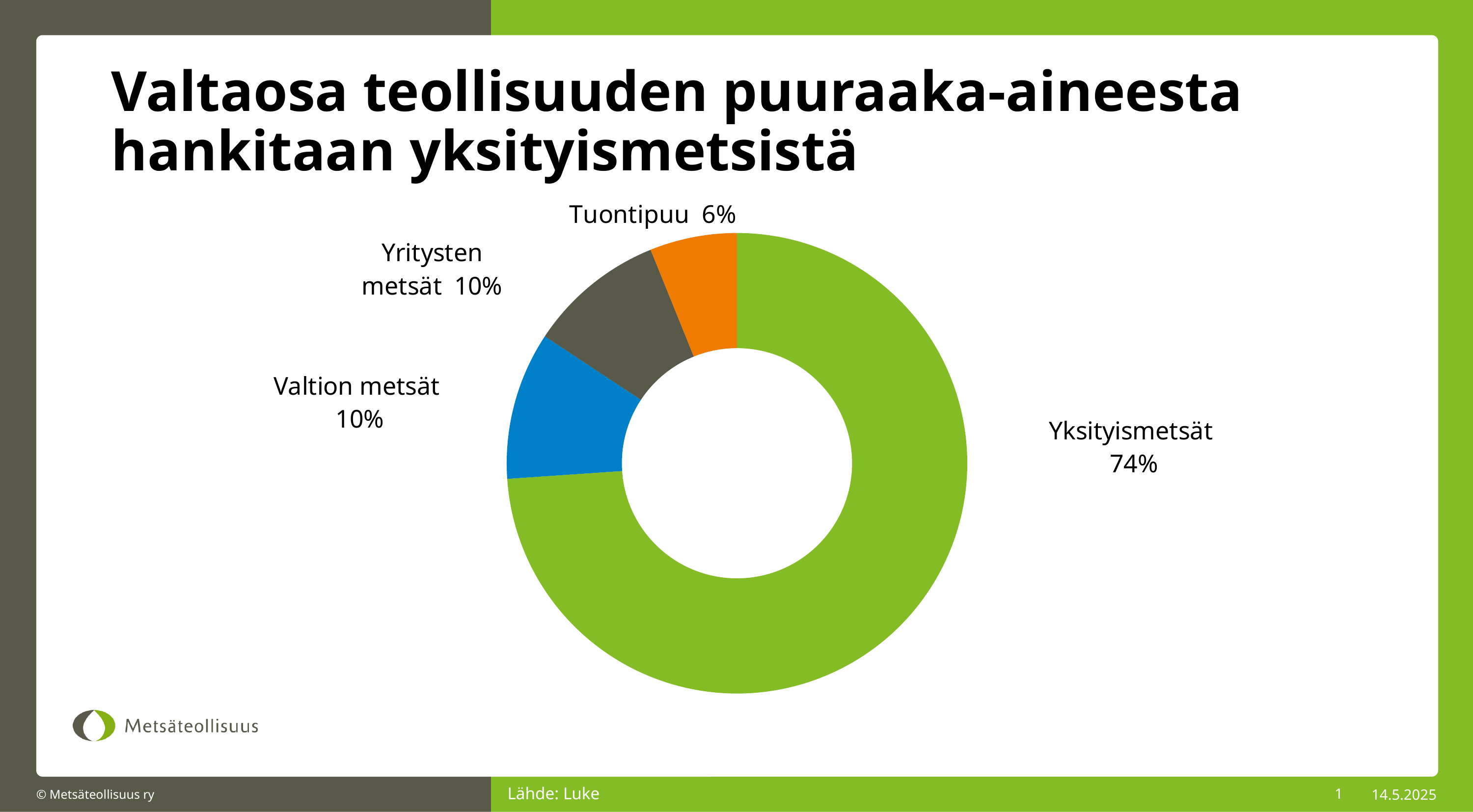
Which is larger, the share of Valtion metsät or the share of Tuontipuu? Valtion metsät What is the difference between the shares of Yksityismetsät and Valtion metsät? 64% What share of the chart does Yksityismetsät account for? 74% What is the value shown for Valtion metsät? 10% What is the value shown for Yritysten metsät? 10% Which category has the largest share? Yksityismetsät What colour is the Tuontipuu slice? Orange What is the value shown for Tuontipuu? 6% What is the difference between the shares of Yritysten metsät and Tuontipuu? 4% What kind of chart is shown on the slide? Doughnut chart How many categories are shown in the chart? 4 Which category has the smallest share? Tuontipuu